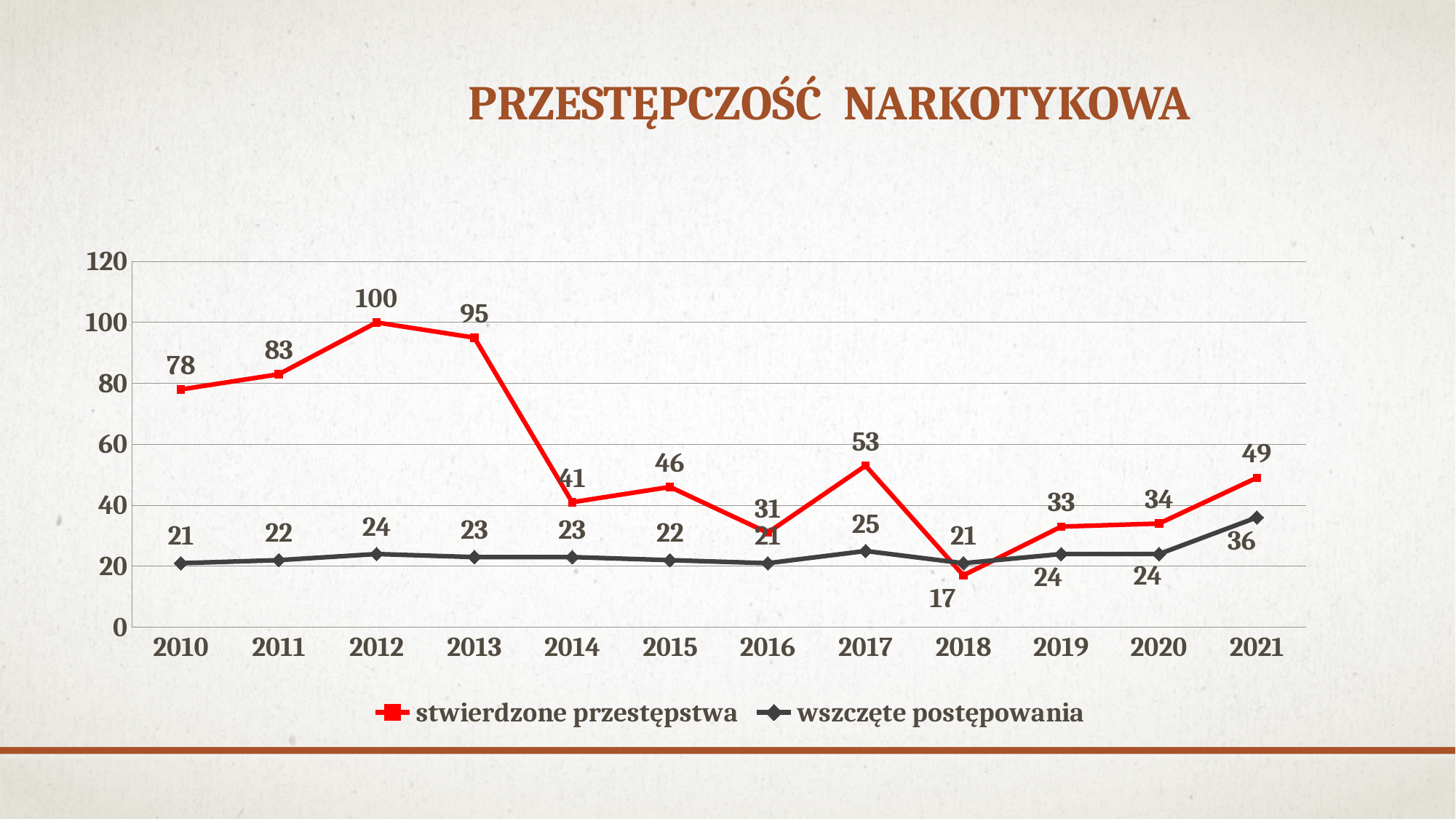
What type of chart is shown on the slide? line chart What is the value of wszczęte postępowania in 2021? 36 How many years are shown on the x axis? 12 How many series does the legend list? 2 What is the value of stwierdzone przestępstwa in 2018? 17 Does stwierdzone przestępstwa rise or fall from 2018 to 2021? rise In which year is stwierdzone przestępstwa lowest? 2018 In which year is wszczęte postępowania highest? 2021 In which year is stwierdzone przestępstwa highest? 2012 Which is larger in 2018: stwierdzone przestępstwa or wszczęte postępowania? wszczęte postępowania What is the difference between stwierdzone przestępstwa in 2013 and in 2014? 54 What is the value of stwierdzone przestępstwa in 2012? 100